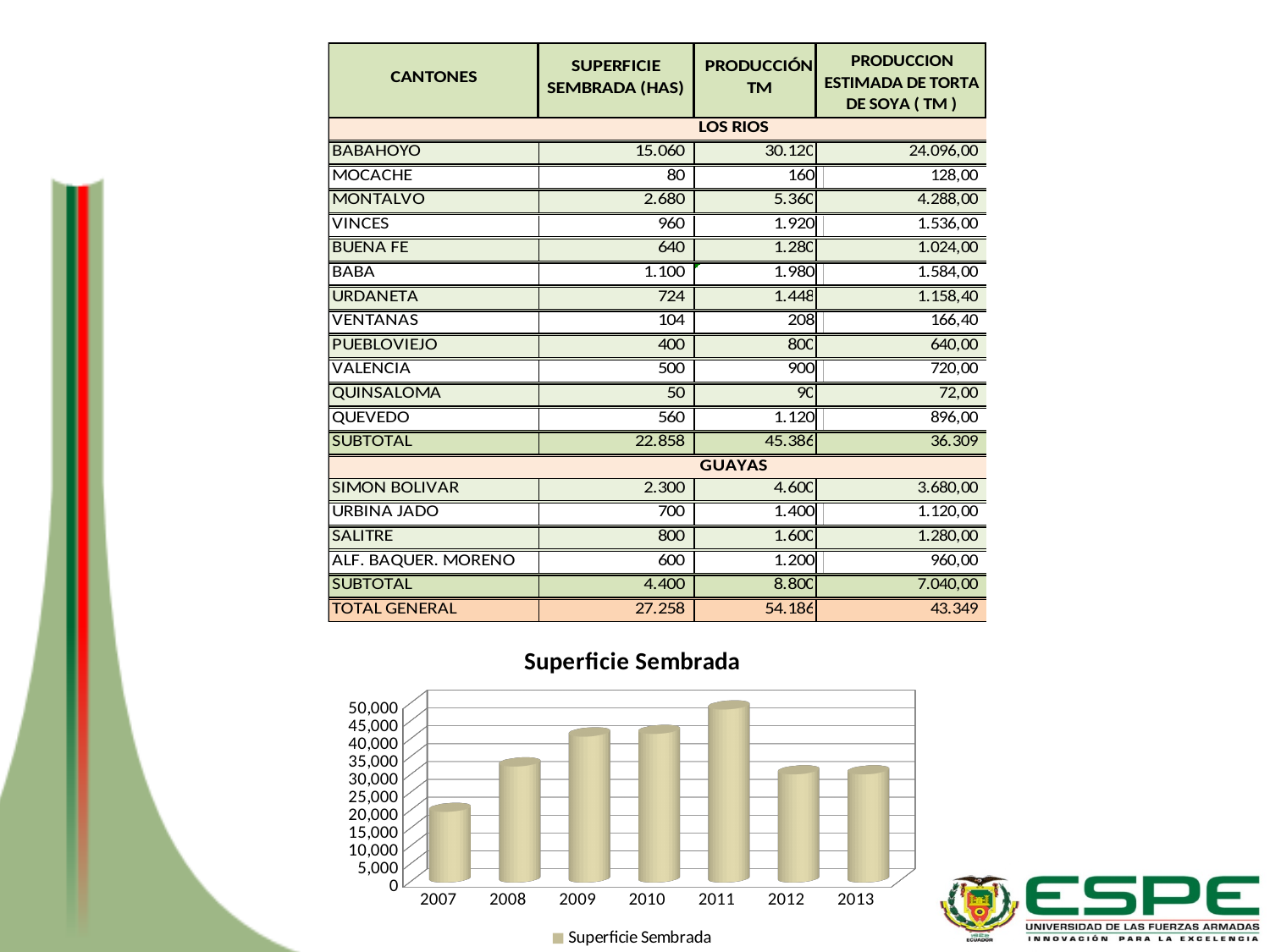
Is the value for 2012 greater or less than 35,000? less Is the value for 2011 greater or less than 45,000? greater How many years are shown on the x axis of the chart? 7 Is the value for 2009 greater or less than 35,000? greater What kind of chart is shown on the slide? bar chart Which year has the highest value in the chart? 2011 How many series does the chart legend list? 1 Which year has the larger value, 2008 or 2009? 2009 Which year has the lowest value in the chart? 2007 What is the title of the chart? Superficie Sembrada Do the values rise or fall from 2007 to 2011? rise